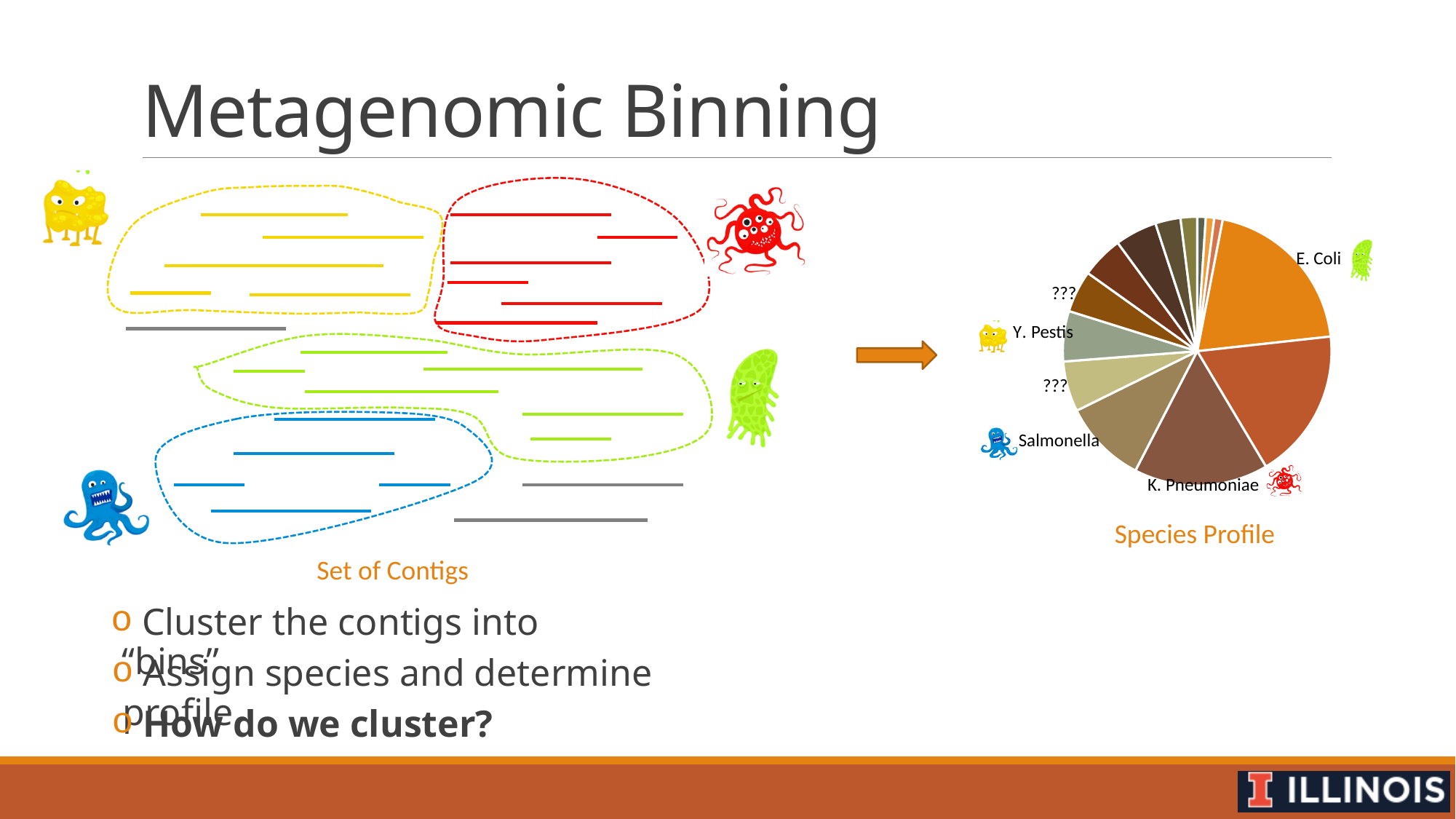
How many species are named by label on the Species Profile pie chart? 4 On the Species Profile pie chart, which slice is larger, E. Coli or Salmonella? E. Coli On the Species Profile pie chart, what label is used for the slices whose species is unknown? ??? What kind of chart is the Species Profile chart on the right of the slide? pie chart What caption is shown beneath the pie chart on the right of the slide? Species Profile